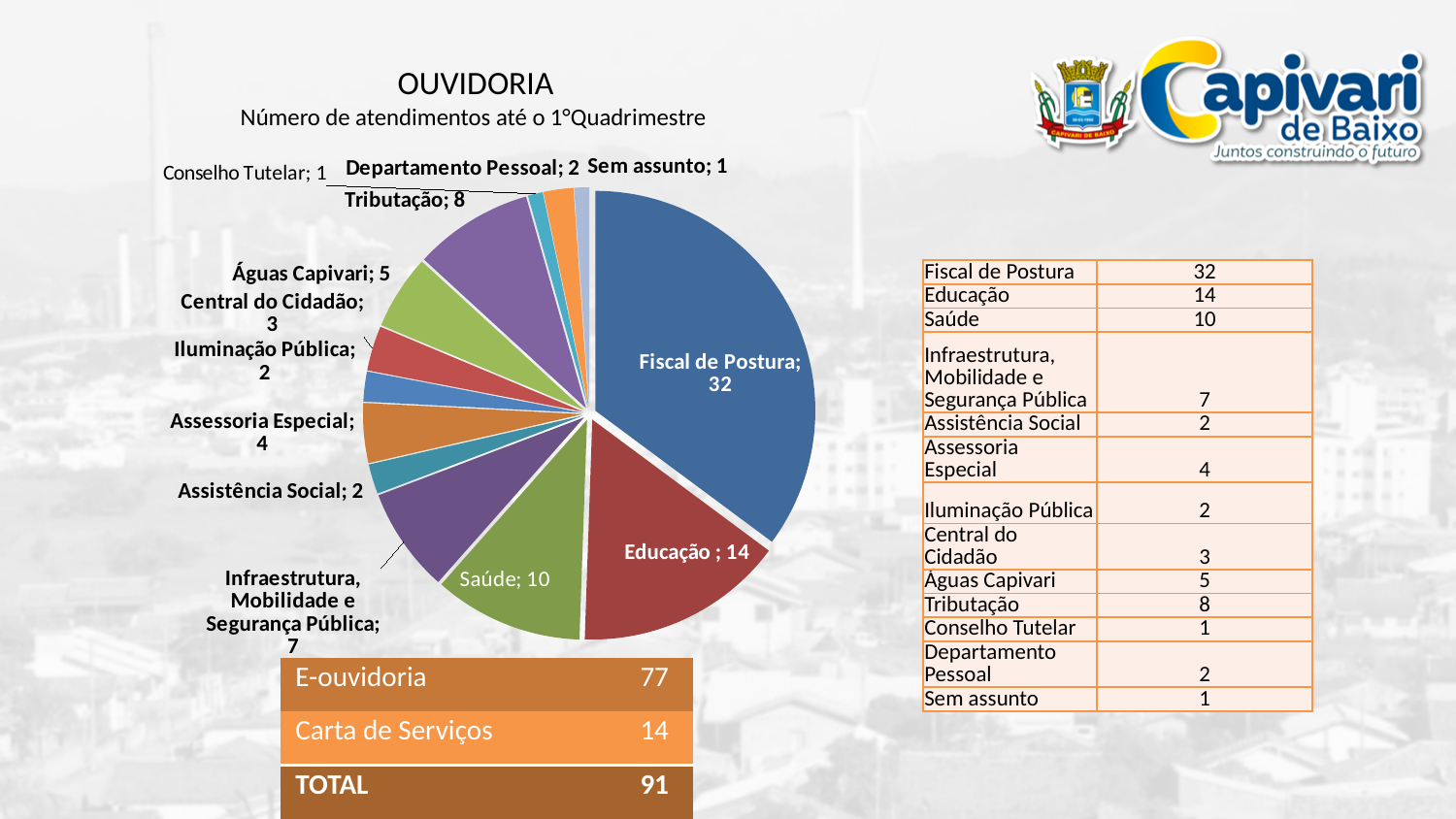
What is the value for Infraestrutura, Mobilidade e Segurança Pública in the pie chart? 7 What is the subtitle shown under the chart title OUVIDORIA? Número de atendimentos até o 1°Quadrimestre Which is larger in the pie chart, Tributação or Saúde? Saúde What is the value for Educação in the pie chart? 14 What type of chart is shown on the slide? pie chart What is the difference between the values for Fiscal de Postura and Educação? 18 What is the value for Fiscal de Postura in the pie chart? 32 How many slices does the pie chart have? 13 What is the difference between the values for Saúde and Águas Capivari? 5 Which is larger in the pie chart, Assessoria Especial or Central do Cidadão? Assessoria Especial What is the value for Tributação in the pie chart? 8 Which category has the largest slice in the pie chart? Fiscal de Postura